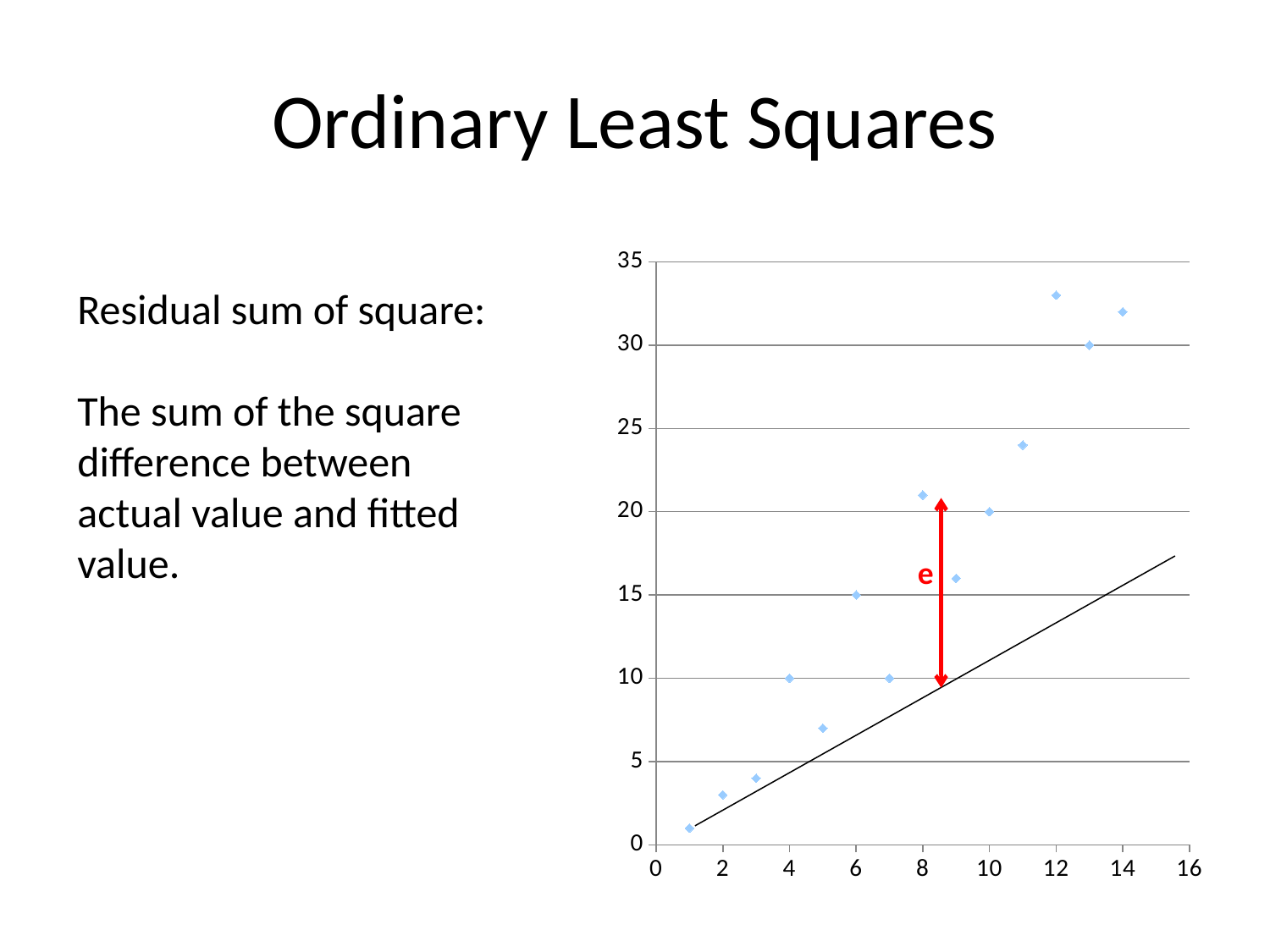
Is the y value of the point at x = 12 greater or less than 30? greater What is the y value of the point at x = 10? 20 Is the y value of the point at x = 1 greater or less than 5? less What is the y value of the point at x = 4? 10 At which x value is the lowest point plotted? 1 What kind of chart is shown on the slide? scatter chart Is the y value of the point at x = 8 greater or less than 20? greater How many data points are plotted in the chart? 14 What is the y value of the point at x = 13? 30 Do the plotted y values generally rise or fall as x increases? rise What letter labels the red arrow in the chart? e What is the y value of the point at x = 6? 15